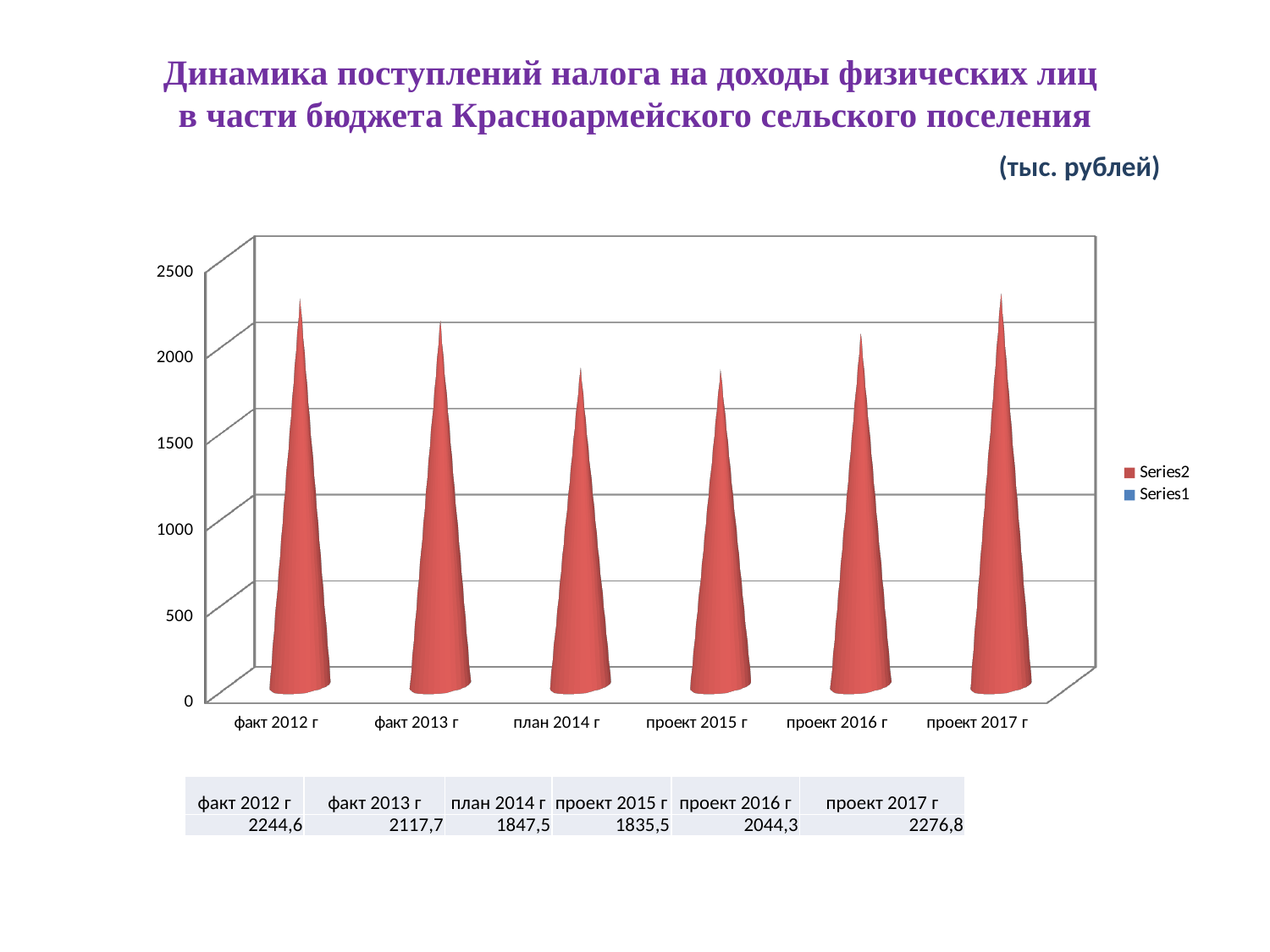
Which category has the highest value? проект 2017 г What is the value for факт 2012 г? 2244,6 What is the value for проект 2016 г? 2044,3 Which category has the lowest value? проект 2015 г What is the value for план 2014 г? 1847,5 What is the difference between the values for проект 2017 г and проект 2016 г? 232,5 What is the difference between the values for факт 2012 г and факт 2013 г? 126,9 Is the value for план 2014 г greater or less than 2000? less Which is larger, the value for факт 2013 г or the value for проект 2016 г? факт 2013 г How many series does the legend list? 2 How many categories are shown on the x axis? 6 What kind of chart is shown on the slide? bar chart